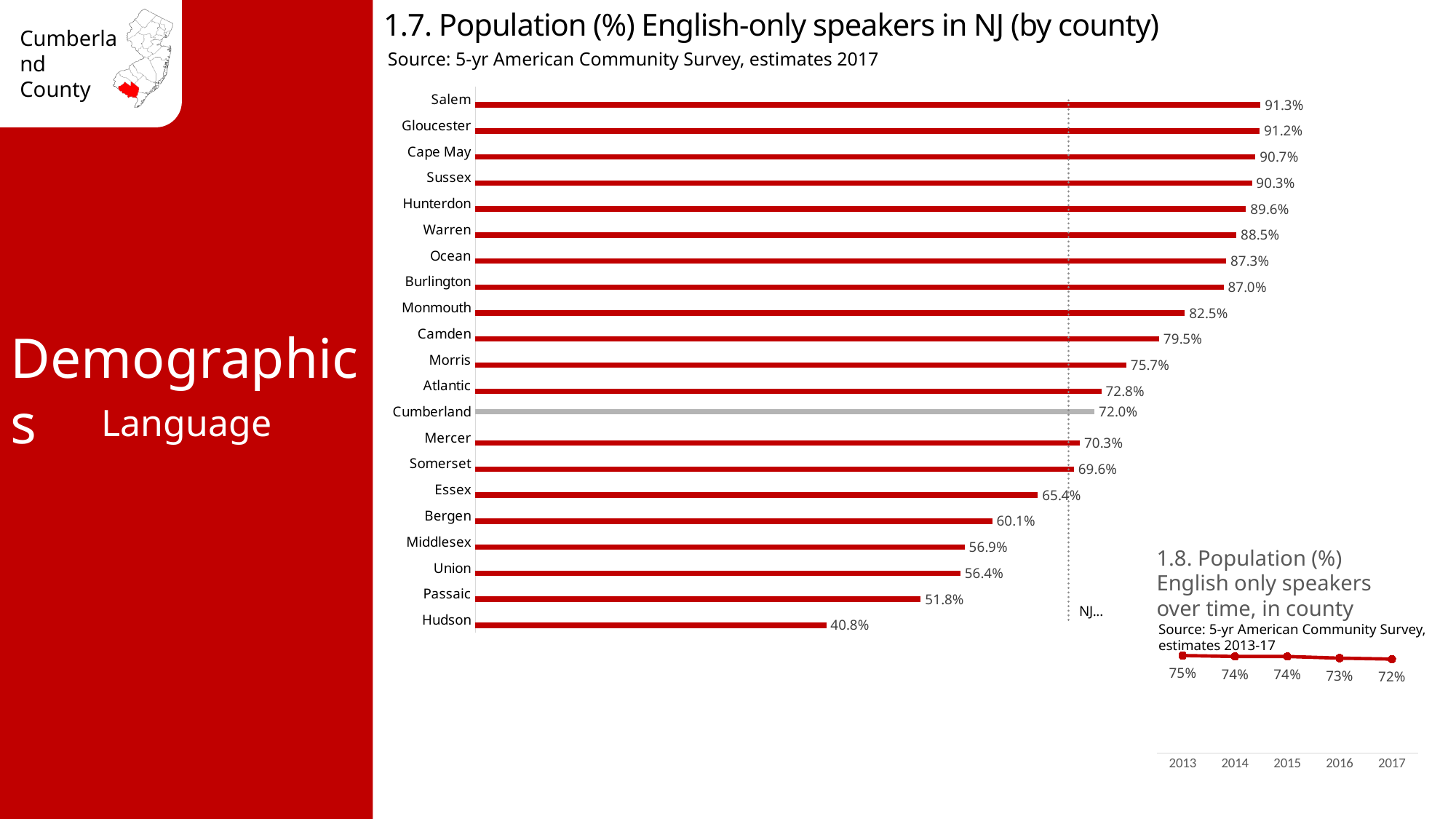
In the chart '1.7. Population (%) English-only speakers in NJ (by county)', which county's bar is coloured grey instead of red? Cumberland In the chart '1.8. Population (%) English only speakers over time, in county', what is the value for 2013? 75% In the chart '1.7. Population (%) English-only speakers in NJ (by county)', what is the value for Hudson? 40.8% In the chart '1.7. Population (%) English-only speakers in NJ (by county)', what is the difference between Salem and Hudson? 50.5% In the chart '1.7. Population (%) English-only speakers in NJ (by county)', which county has the lowest value? Hudson What kind of chart is '1.7. Population (%) English-only speakers in NJ (by county)'? bar chart In the chart '1.8. Population (%) English only speakers over time, in county', do the values rise or fall from 2013 to 2017? fall In the chart '1.7. Population (%) English-only speakers in NJ (by county)', which is larger, Camden or Morris? Camden In the chart '1.8. Population (%) English only speakers over time, in county', what is the value for 2017? 72% In the chart '1.7. Population (%) English-only speakers in NJ (by county)', what is the value for Cumberland? 72.0% In the chart '1.7. Population (%) English-only speakers in NJ (by county)', which county has the highest value? Salem In the chart '1.7. Population (%) English-only speakers in NJ (by county)', how many counties are shown? 21